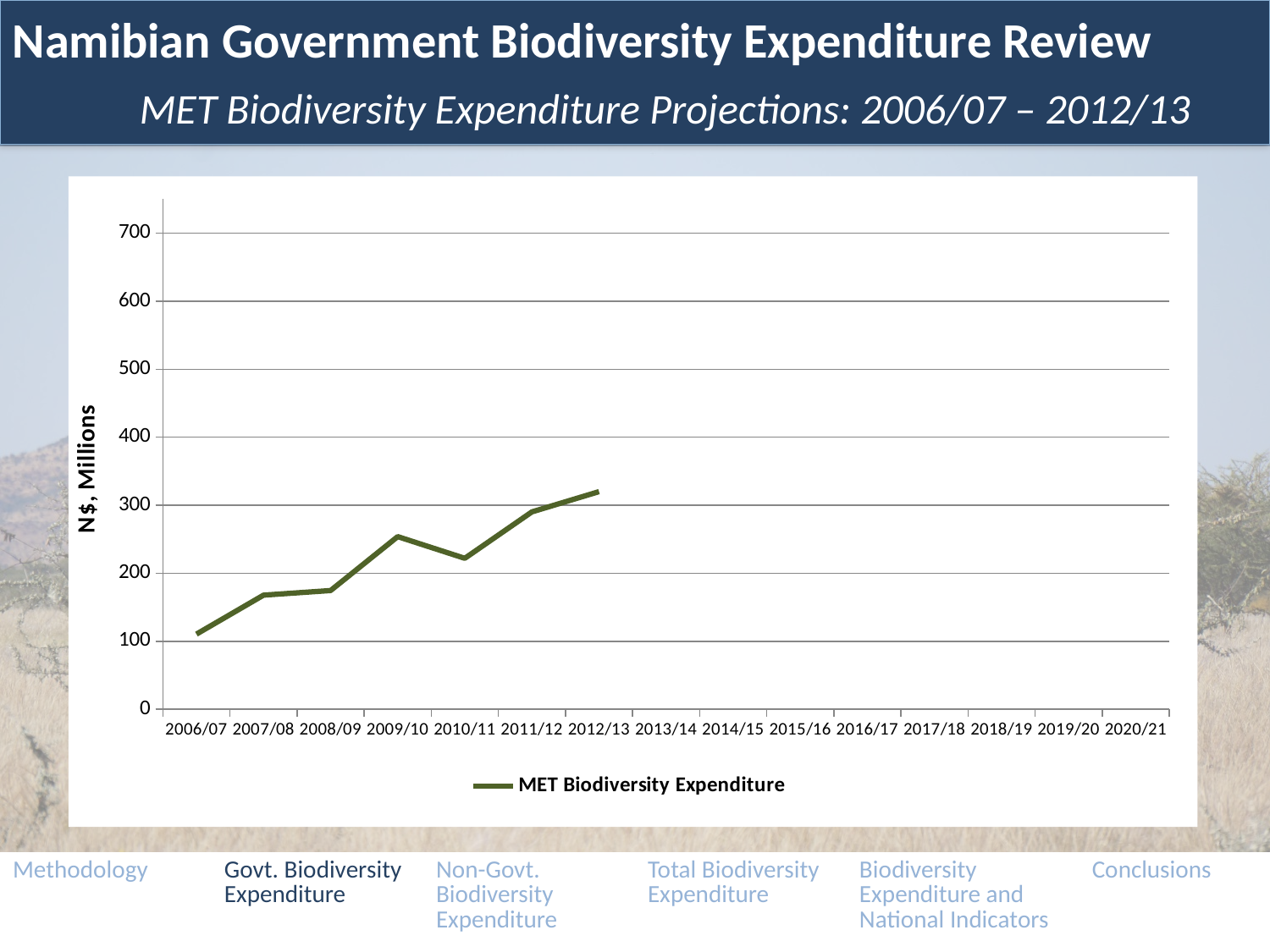
Which year has the lowest MET Biodiversity Expenditure? 2006/07 Is the value for 2010/11 greater or less than 300? less What is the name of the series shown in the legend? MET Biodiversity Expenditure Is the value for 2012/13 greater or less than 300? greater Which is larger, the value for 2009/10 or the value for 2010/11? 2009/10 What is the label on the vertical axis? N$, Millions What kind of chart is shown on the slide? line chart Which year has the highest MET Biodiversity Expenditure? 2012/13 Does MET Biodiversity Expenditure generally rise or fall from 2006/07 to 2012/13? rise Is the value for 2006/07 greater or less than 200? less How many series does the legend list? 1 How many years have a plotted value on the line? 7